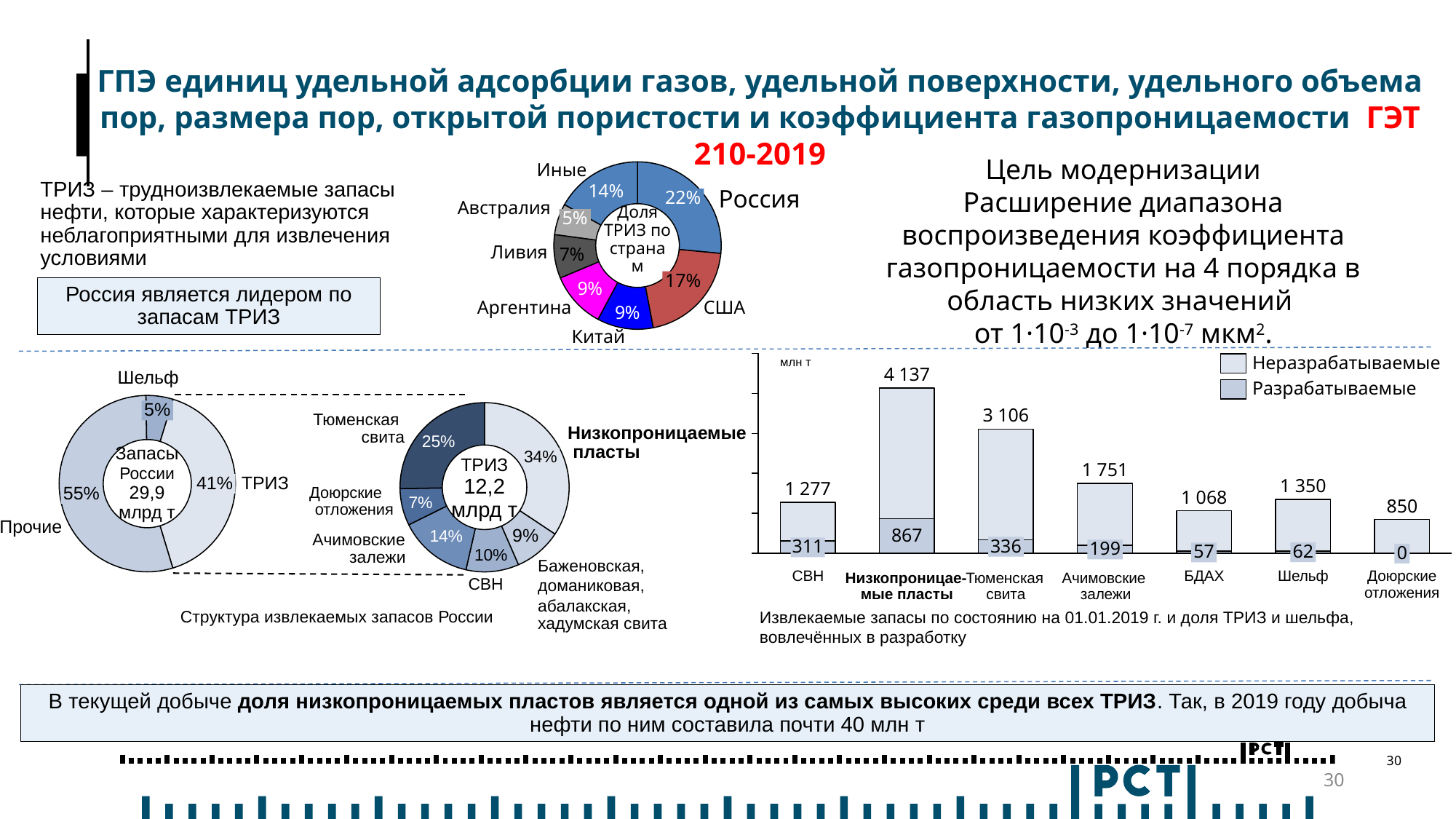
In the bar chart on the right, what is the difference between the total for Тюменская свита and the total for Ачимовские залежи? 1 355 In the donut chart 'ТРИЗ 12,2 млрд т', what share do Низкопроницаемые пласты have? 34% In the bottom-left donut chart 'Запасы России 29,9 млрд т', what share is labelled Шельф? 5% In the bottom-left donut chart 'Запасы России 29,9 млрд т', what share is labelled ТРИЗ? 41% In the bar chart on the right, how many series does the legend list? 2 In the top donut chart 'Доля ТРИЗ по странам', what is the share for Австралия? 5% In the bar chart on the right, which category has the lowest total value? Доюрские отложения In the bar chart on the right, what is the total value for Низкопроницаемые пласты? 4 137 In the top donut chart 'Доля ТРИЗ по странам', how many slices are shown? 7 In the donut chart 'ТРИЗ 12,2 млрд т', which is larger: Тюменская свита or Ачимовские залежи? Тюменская свита In the top donut chart 'Доля ТРИЗ по странам', which country has the largest share? Россия In the top donut chart 'Доля ТРИЗ по странам', what share does Россия have? 22%